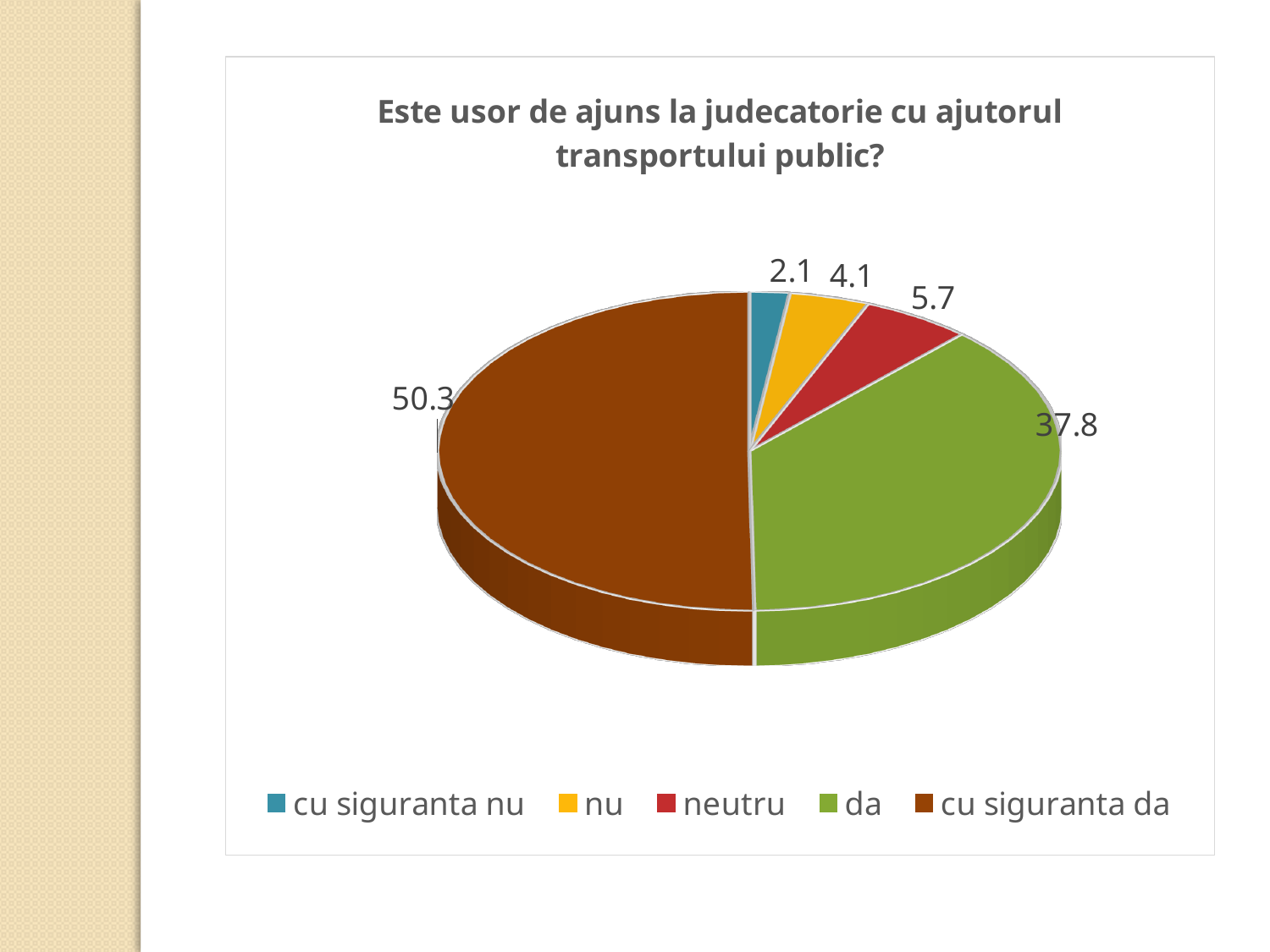
Which category has the smallest slice? cu siguranta nu What is the value for "neutru"? 5.7 What is the title of the chart? Este usor de ajuns la judecatorie cu ajutorul transportului public? What is the difference between the values for "cu siguranta da" and "da"? 12.5 Which is larger, the value for "neutru" or the value for "nu"? neutru What type of chart is shown on the slide? pie chart How many categories does the pie chart have? 5 What is the value for "nu"? 4.1 What is the value for "cu siguranta da"? 50.3 What is the value for "da"? 37.8 What is the value for "cu siguranta nu"? 2.1 Which category has the largest slice? cu siguranta da